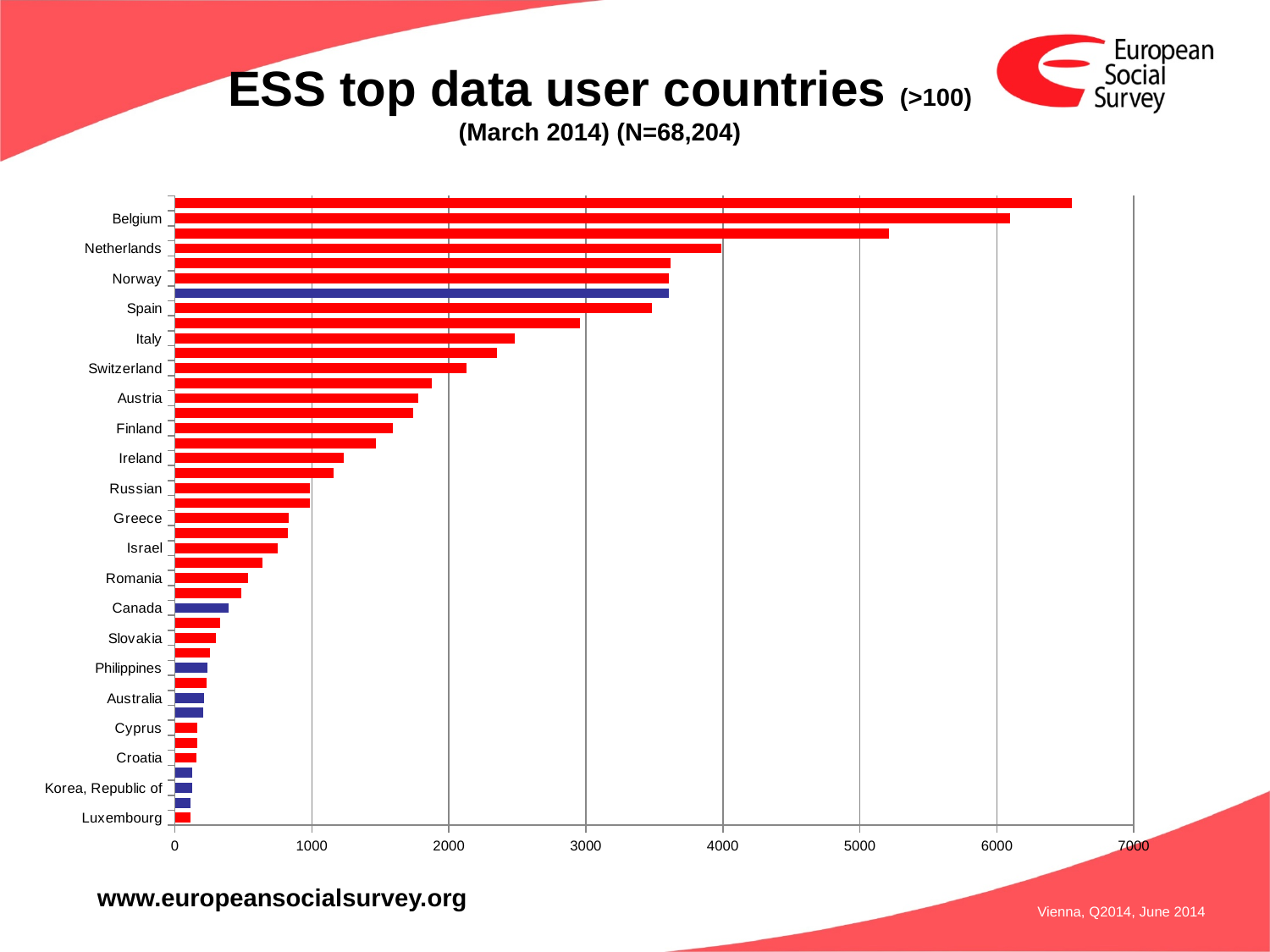
Is the value for Belgium greater or less than 5000? greater Do the bar values increase or decrease going from the top of the chart to the bottom? decrease Is the value for Ireland greater or less than 1000? greater Which has a larger value, Italy or Austria? Italy Which has a larger value, Greece or Romania? Greece Is the value for Greece greater or less than 1000? less What kind of chart is shown on the slide? bar chart What is the title of the chart on the slide? ESS top data user countries (>100) (March 2014) (N=68,204) Which has a larger value, Belgium or Netherlands? Belgium